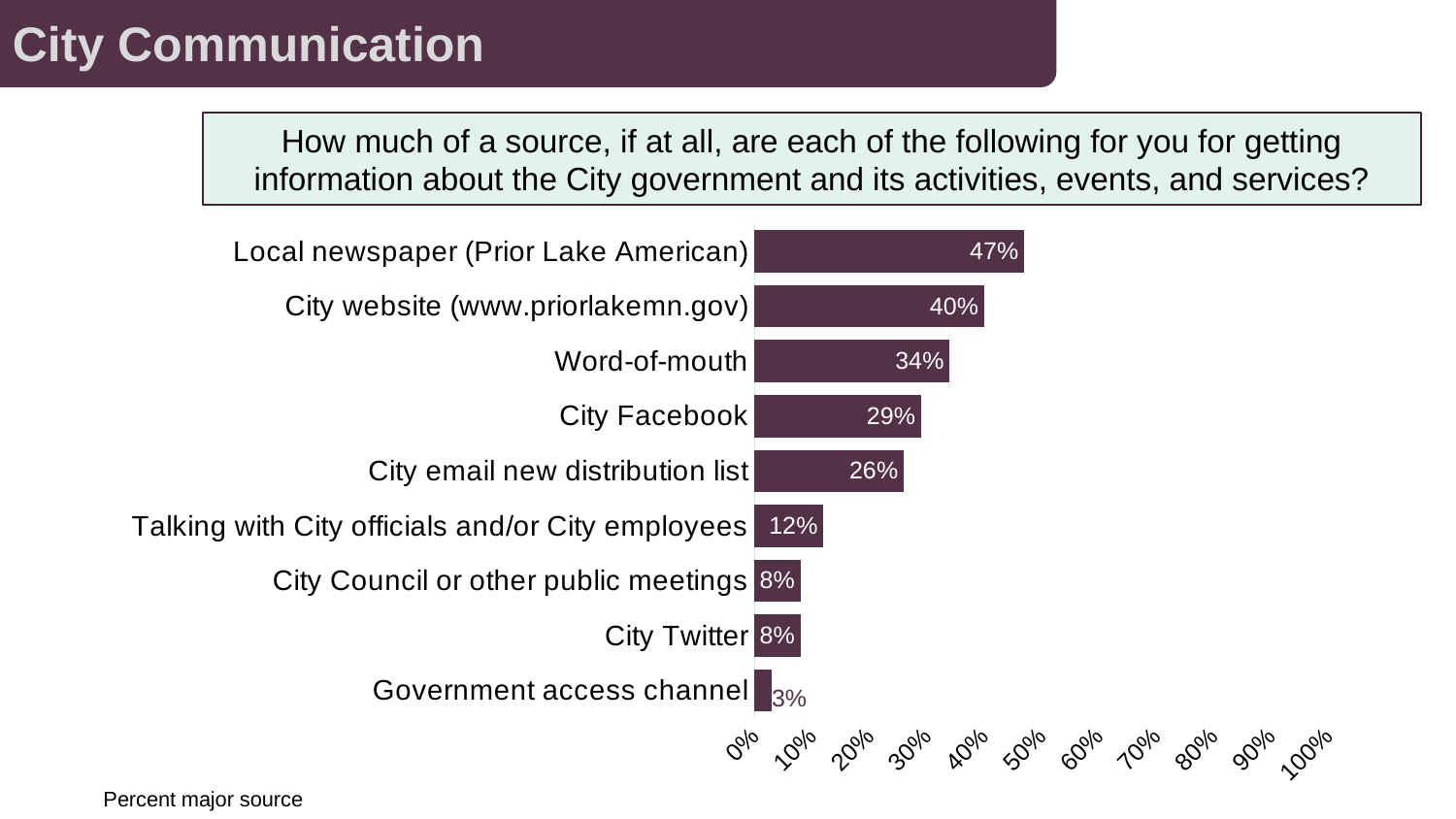
What percentage of respondents cite the local newspaper (Prior Lake American) as a major source? 47% What does the note below the chart say the values represent? Percent major source What is the value for City Facebook? 29% What is the value for the City email new distribution list? 26% Is the value for the local newspaper greater or less than 50%? less Which is larger, the value for City Facebook or the value for Word-of-mouth? Word-of-mouth Which source has the lowest percentage? Government access channel What is the value for Talking with City officials and/or City employees? 12% What is the difference between the values for the City website and Word-of-mouth? 6% What kind of chart is shown on the slide? Bar chart Which source has the highest percentage? Local newspaper (Prior Lake American) How many sources are shown in the chart? 9